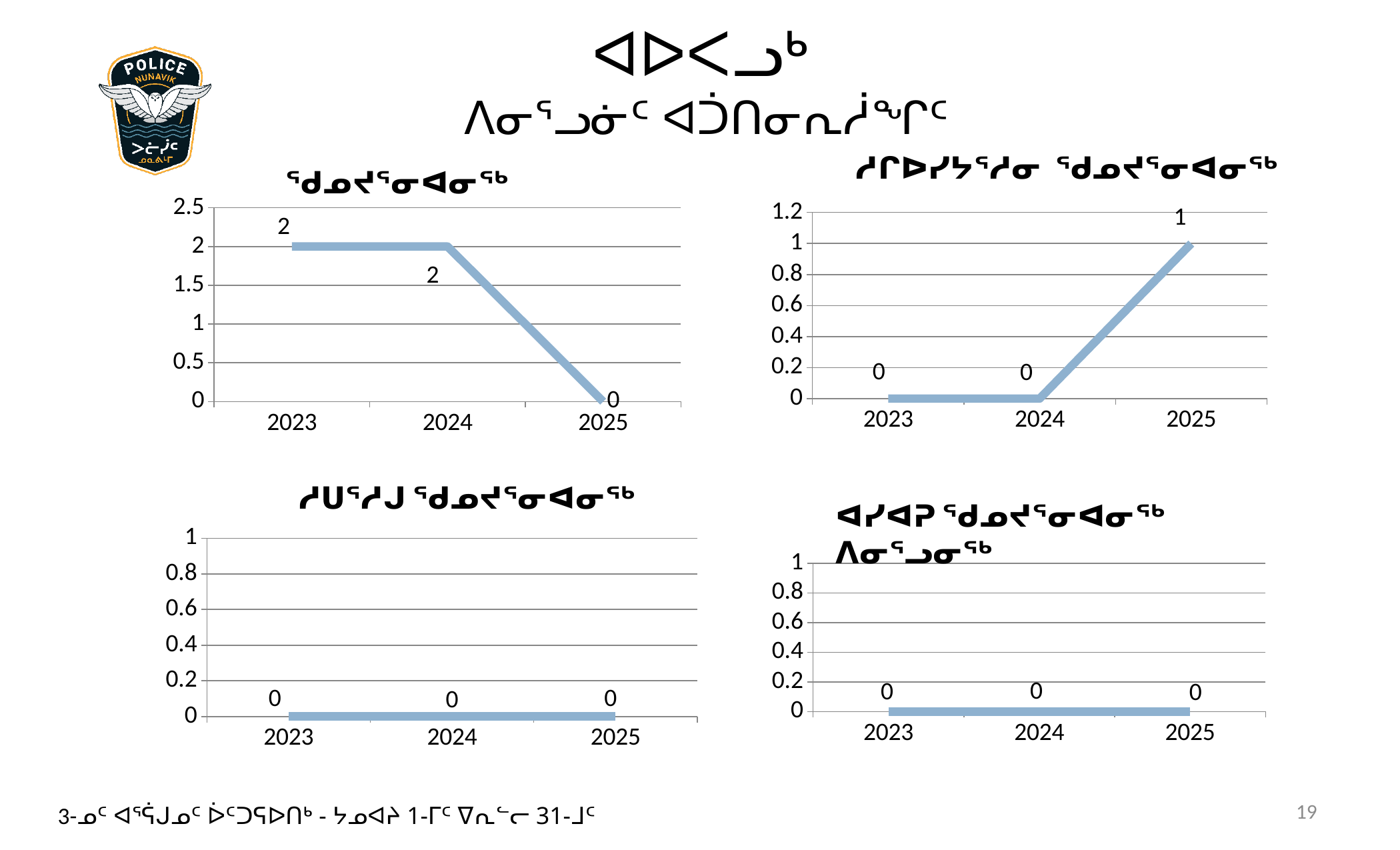
In the top-left chart, do the values rise or fall from 2024 to 2025? fall What kind of chart is the top-left chart? line chart How many years are plotted on the x axis of the bottom-left chart? 3 In the top-left chart, what is the value for 2025? 0 In the top-right chart, what is the value for 2024? 0 In the top-right chart, which year has the highest value? 2025 In the top-left chart, what is the value for 2023? 2 In the top-left chart, what is the difference between the values for 2024 and 2025? 2 In the top-right chart, do the values rise or fall from 2024 to 2025? rise In the top-right chart, what is the value for 2025? 1 In the bottom-left chart, what is the value for 2024? 0 In the bottom-right chart, what is the value for 2025? 0